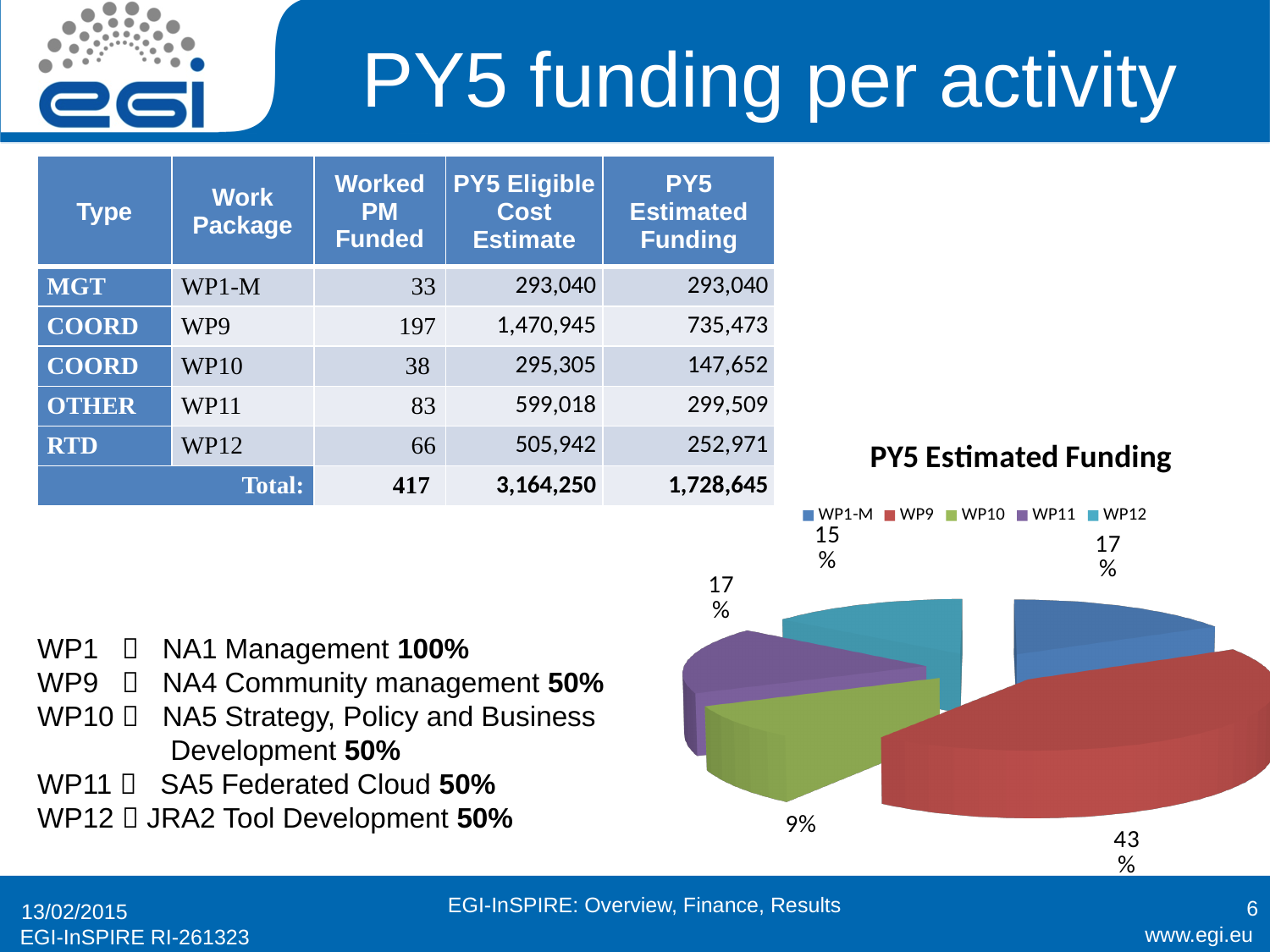
What kind of chart is shown on the slide? pie chart What is the title of the chart? PY5 Estimated Funding How many slices does the pie chart have? 5 How many entries does the chart's legend list? 5 Which work package has the largest share of PY5 estimated funding in the pie chart? WP9 What share of PY5 estimated funding does WP1-M have in the pie chart? 17% What share of PY5 estimated funding does WP12 have in the pie chart? 15% Which has the larger share in the pie chart, WP9 or WP12? WP9 Which work package has the smallest share of PY5 estimated funding in the pie chart? WP10 What is the difference in percentage points between the WP9 share and the WP10 share in the pie chart? 34 What share of PY5 estimated funding does WP10 have in the pie chart? 9%